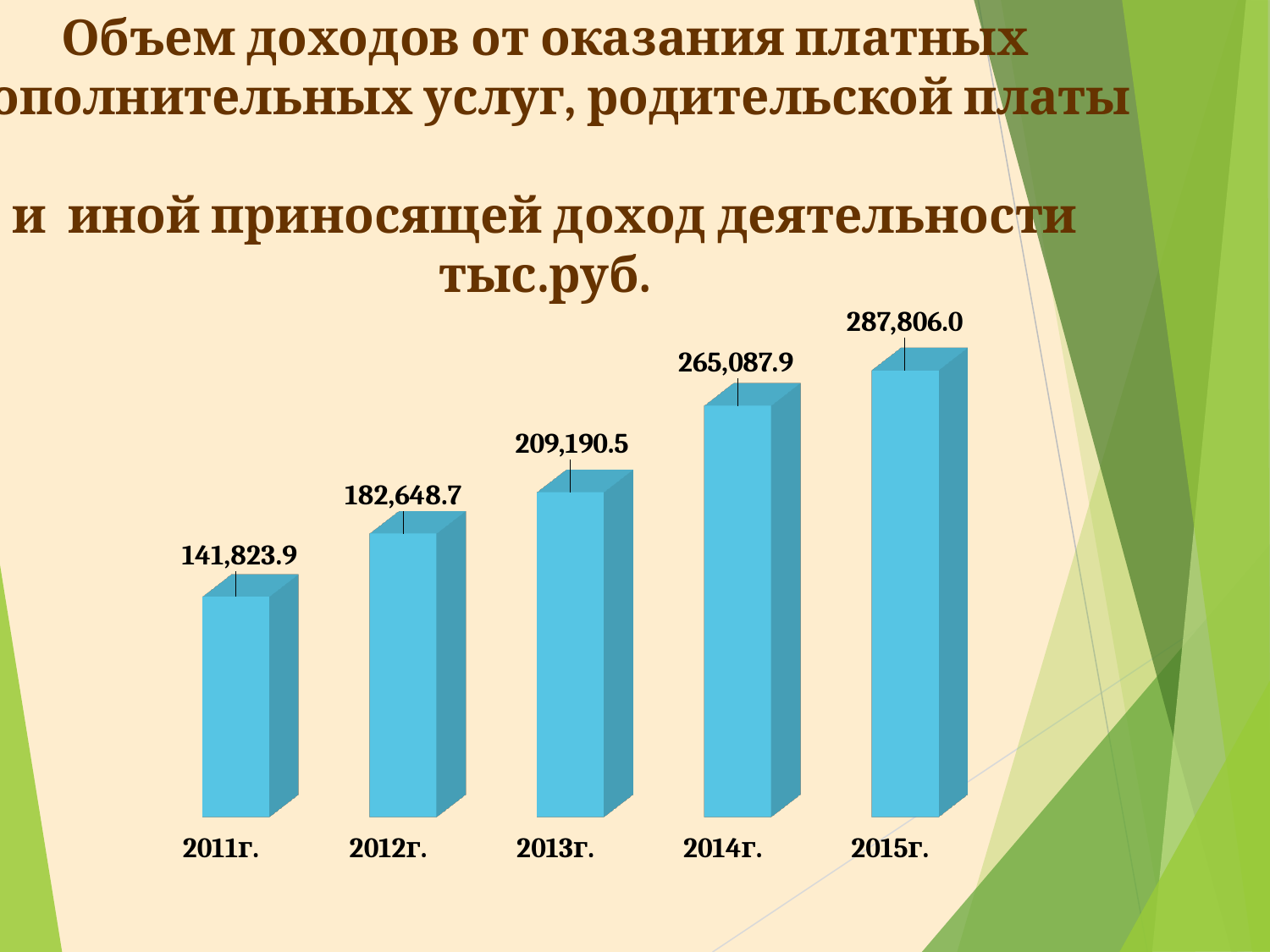
What is the value for 2013г.? 209,190.5 What is the difference between the values for 2012г. and 2011г.? 40,824.8 What kind of chart is shown on the slide? Bar chart What is the difference between the values for 2015г. and 2014г.? 22,718.1 What is the difference between the values for 2014г. and 2013г.? 55,897.4 Do the values rise or fall from 2011г. to 2015г.? Rise What is the value for 2011г.? 141,823.9 How many years are shown on the chart? 5 Which year has the highest value? 2015г. Which is larger, the value for 2012г. or the value for 2014г.? 2014г. What is the value for 2015г.? 287,806.0 Which year has the lowest value? 2011г.